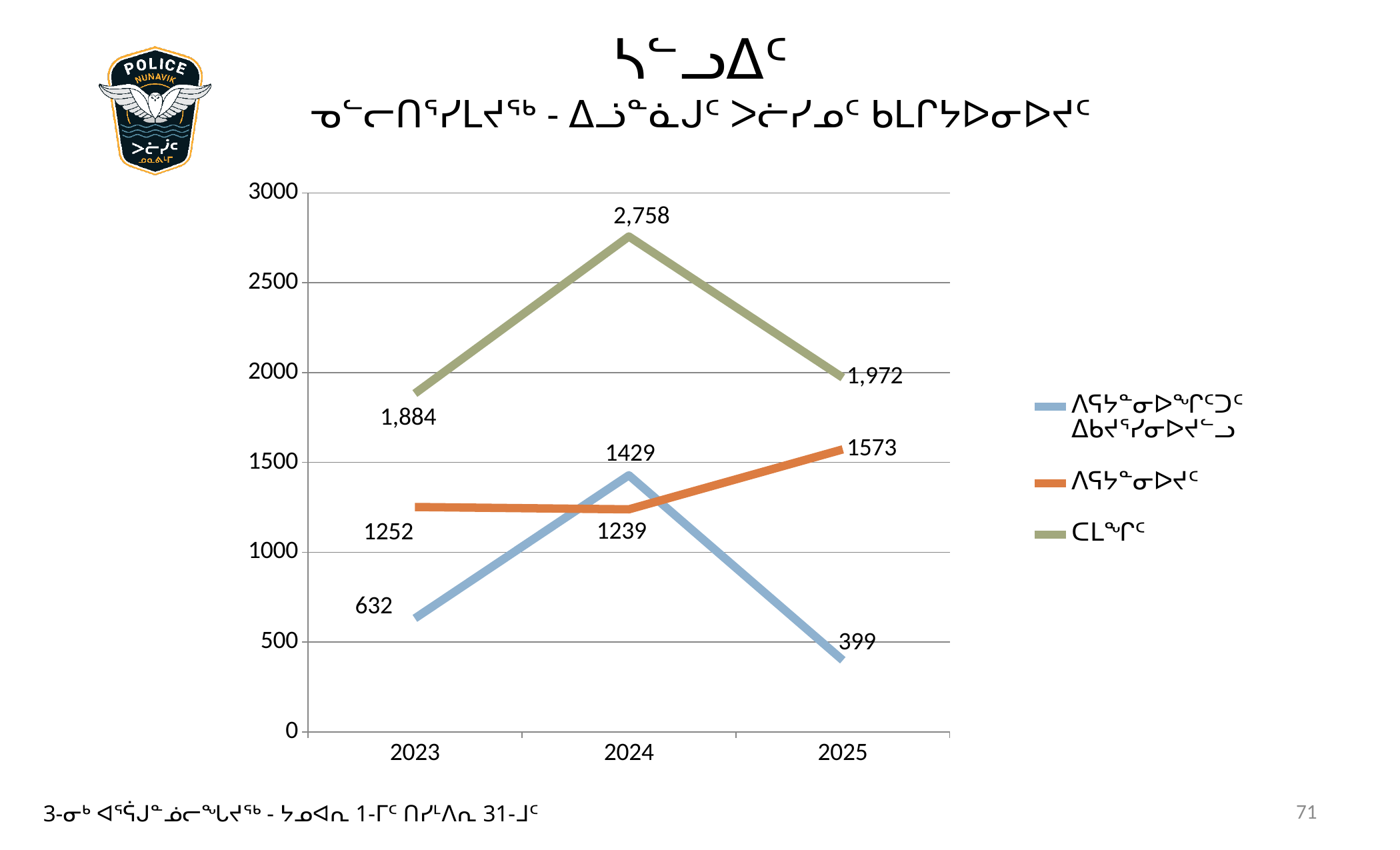
In 2024, which is larger: the blue line or the orange line? the blue line What is the value of the blue line in 2025? 399 What is the value of the orange line in 2023? 1252 What is the value of the green line in 2024? 2,758 In which year is the blue line at its lowest value? 2025 How many series does the legend list? 3 What is the difference between the green line's 2024 value and its 2023 value? 874 How many years are shown on the x axis? 3 What is the difference between the orange line's 2025 value and its 2024 value? 334 Is the value of the green line in 2025 greater or less than 1500? greater What kind of chart is shown on the slide? line chart In which year does the green line reach its highest value? 2024